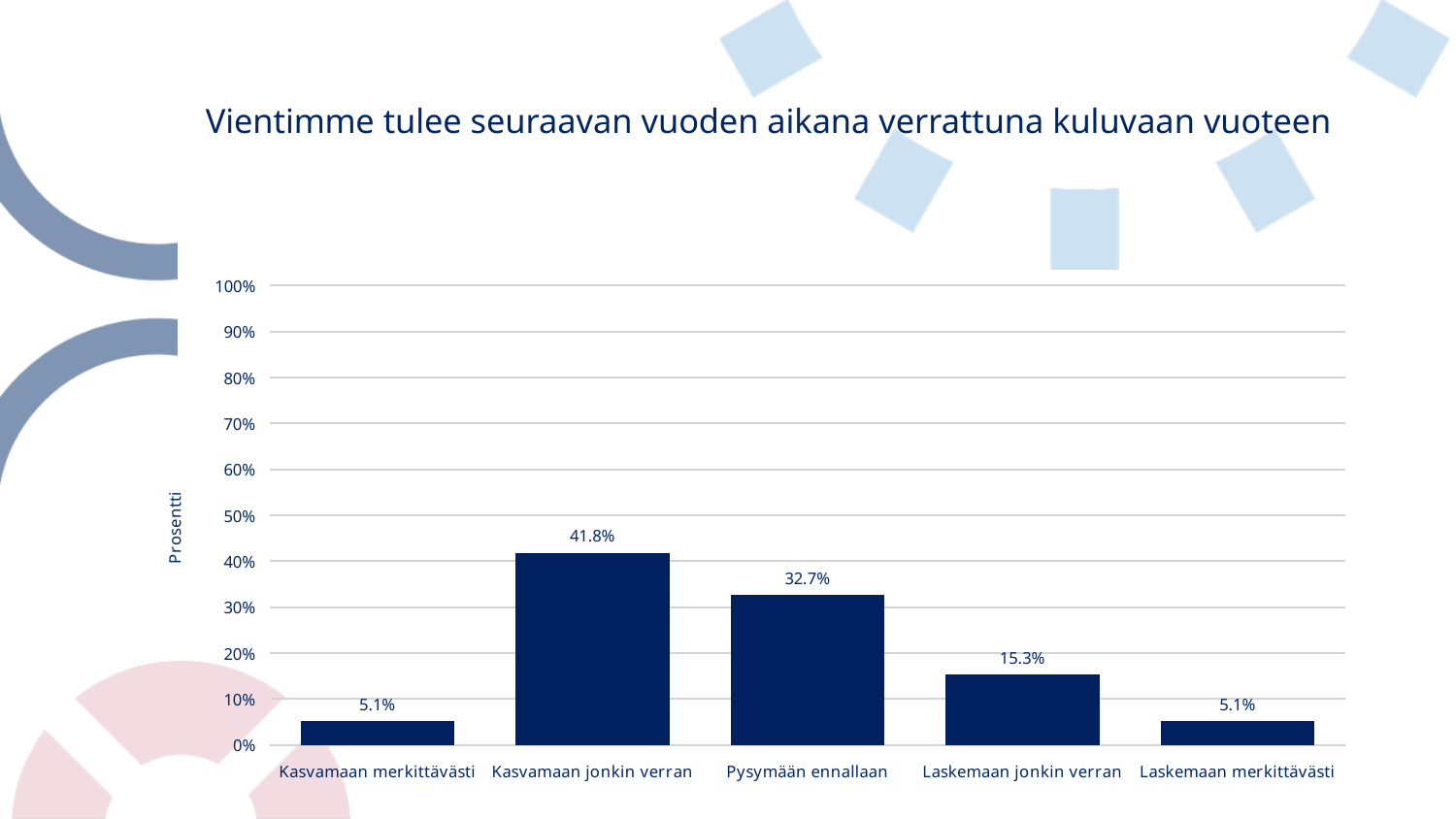
Is the value for "Kasvamaan jonkin verran" greater or less than 50%? less What is the value for "Pysymään ennallaan"? 32.7% What is the value for "Kasvamaan merkittävästi"? 5.1% What is the difference between the values for "Kasvamaan jonkin verran" and "Pysymään ennallaan"? 9.1% What is the value for "Laskemaan jonkin verran"? 15.3% Which is larger, the value for "Pysymään ennallaan" or the value for "Laskemaan jonkin verran"? Pysymään ennallaan Which category has the highest value? Kasvamaan jonkin verran What is the value for "Kasvamaan jonkin verran"? 41.8% How many categories are shown on the x axis? 5 What is the title of the chart? Vientimme tulee seuraavan vuoden aikana verrattuna kuluvaan vuoteen What is the label of the y axis? Prosentti What kind of chart is shown on the slide? bar chart